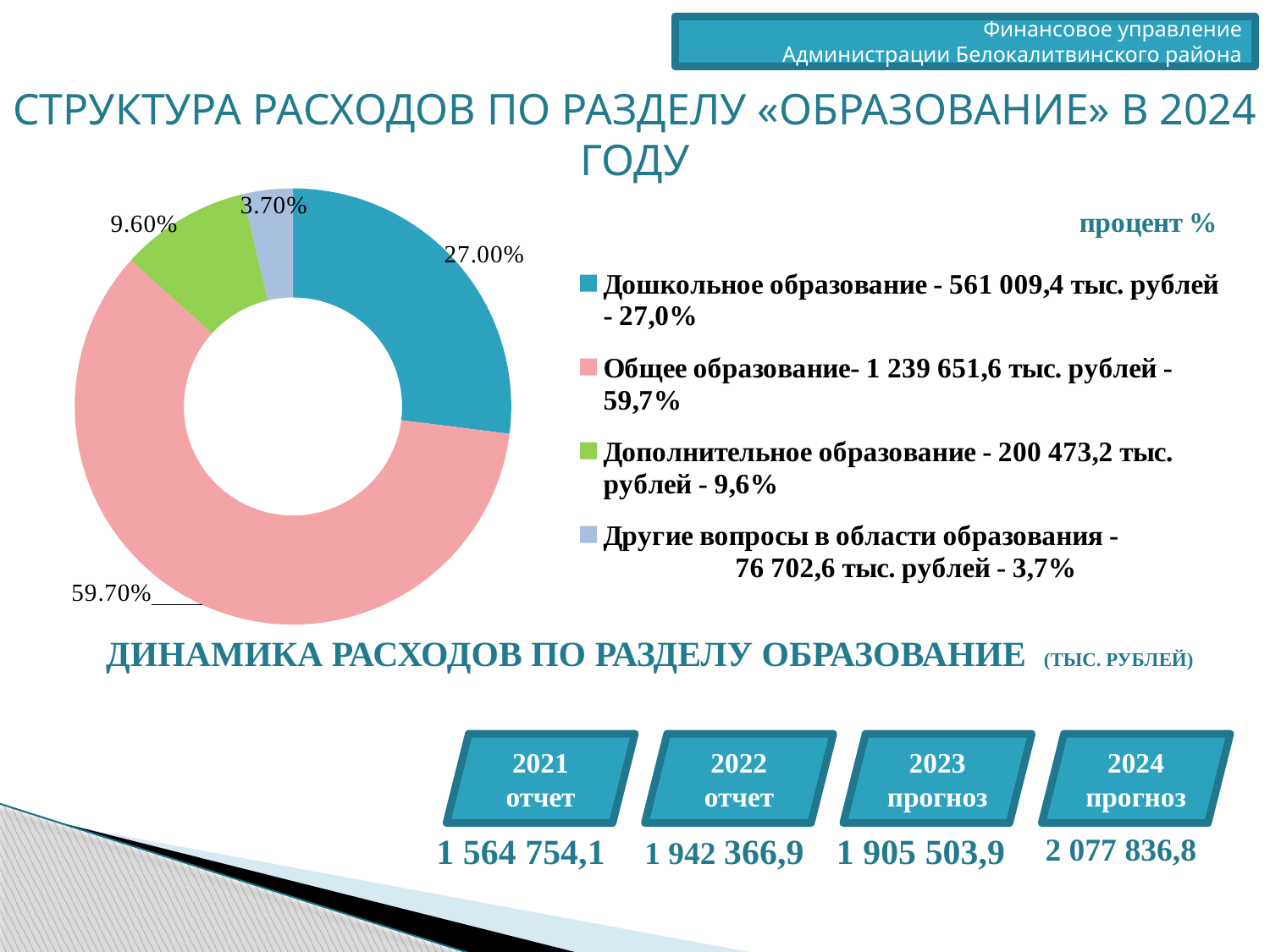
Which category has the smallest share in the doughnut chart? Другие вопросы в области образования What kind of chart is shown on the slide? Doughnut (pie) chart Which is larger in the doughnut chart: Дополнительное образование or Другие вопросы в области образования? Дополнительное образование What is the difference in percentage points between Общее образование and Дошкольное образование in the doughnut chart? 32.70% How many slices does the doughnut chart have? 4 What percentage is shown for Дошкольное образование in the doughnut chart? 27.00% What percentage is shown for Дополнительное образование in the doughnut chart? 9.60% Which category has the largest share in the doughnut chart? Общее образование What percentage is shown for Общее образование in the doughnut chart? 59.70% How many entries does the legend of the doughnut chart list? 4 What colour is the slice for Дошкольное образование in the doughnut chart? Blue (teal) What percentage is shown for Другие вопросы в области образования in the doughnut chart? 3.70%